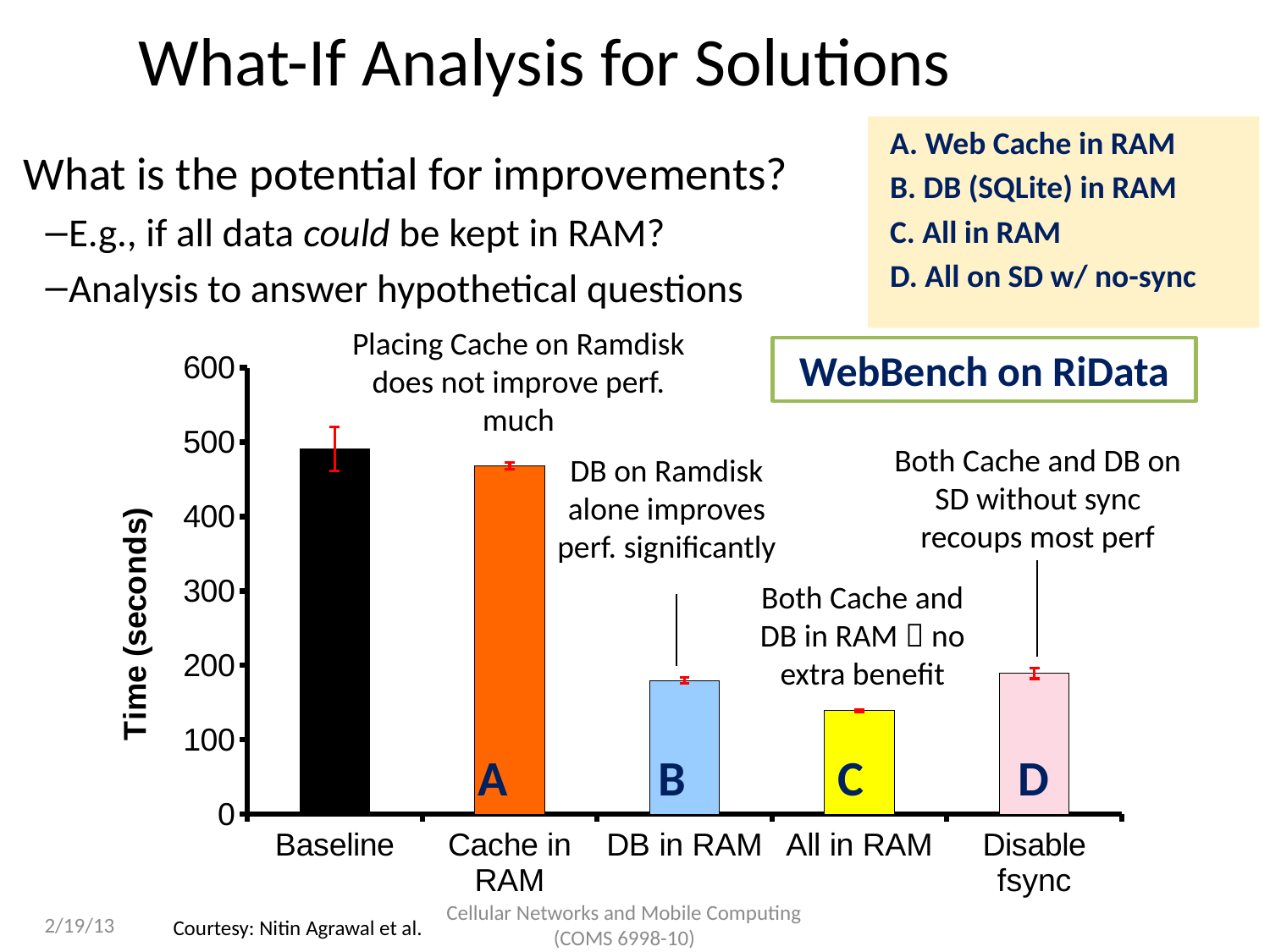
Is the value for All in RAM greater or less than 200? less Which category has the highest time in the chart? Baseline Is the value for Baseline greater or less than 400? greater Is the value for Cache in RAM greater or less than 400? greater What kind of chart is shown on the slide? bar chart What is the label of the y axis of the chart? Time (seconds) Which category has the lowest time in the chart? All in RAM What letter is printed on the DB in RAM bar? B How many categories are plotted on the x axis of the chart? 5 Which has a larger value, Cache in RAM or Disable fsync? Cache in RAM Which has a larger value, Baseline or DB in RAM? Baseline